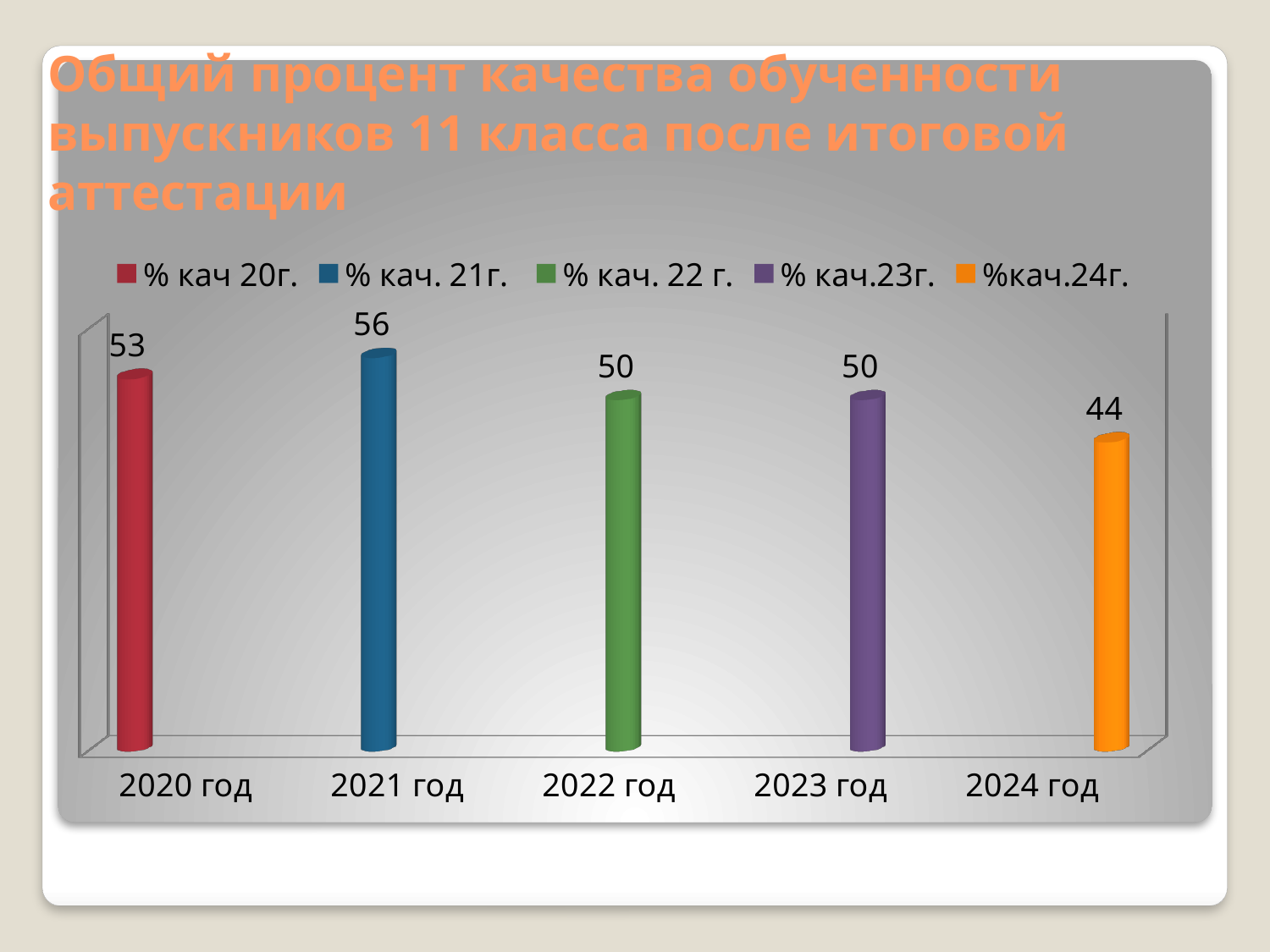
Which year has the lowest value? 2024 год Which is larger, the value for 2020 год or the value for 2022 год? 2020 год What is the value shown for 2023 год? 50 What is the value shown for 2021 год? 56 What kind of chart is shown on the slide? Bar chart How many years are shown on the x axis? 5 How many series does the legend list? 5 What is the difference between the values for 2021 год and 2024 год? 12 What is the value shown for 2024 год? 44 Which year has the highest value? 2021 год What is the value shown for 2020 год? 53 What colour is the bar for 2024 год? Orange